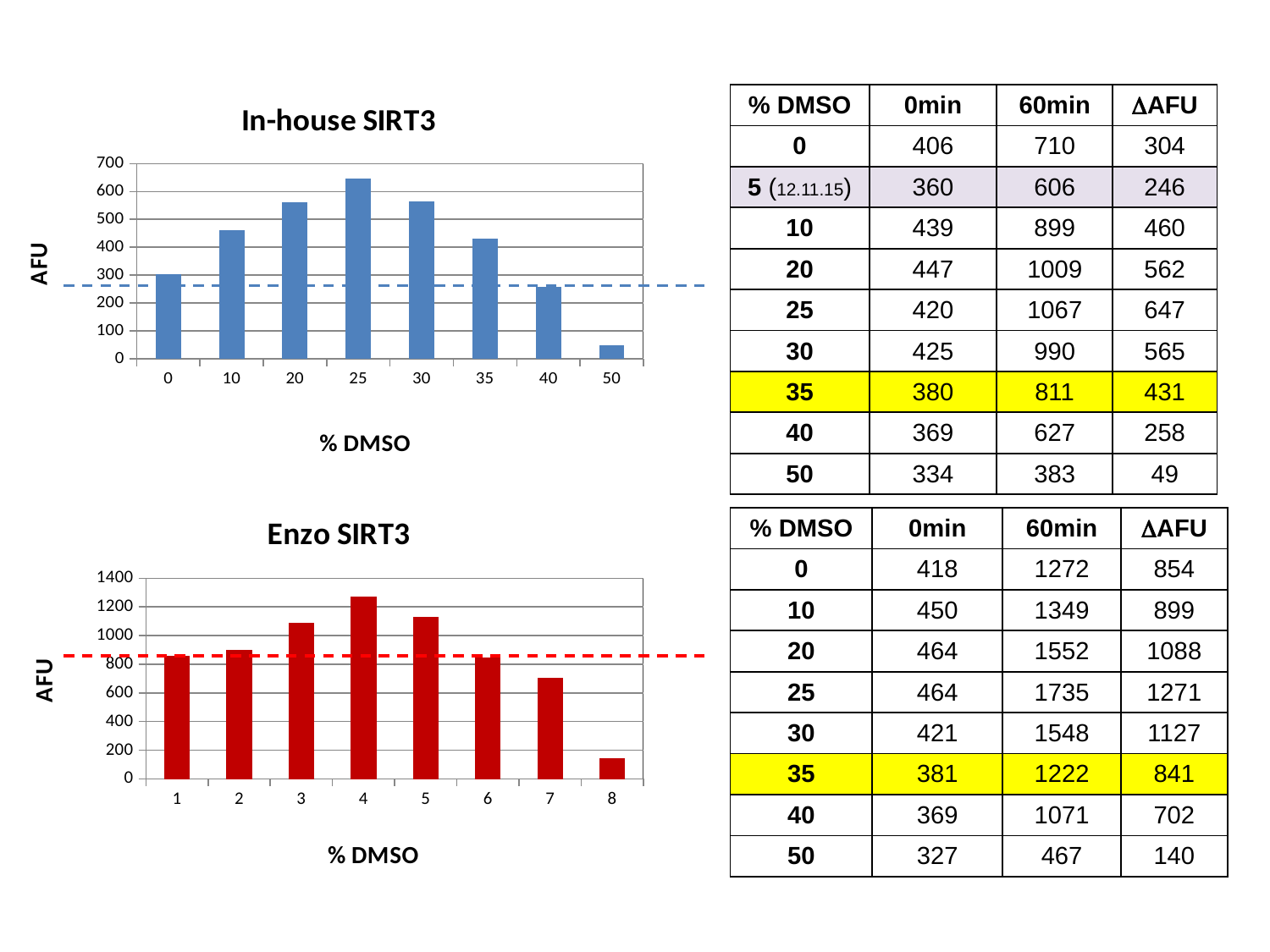
In the Enzo SIRT3 chart, which is larger, the value for category 2 or for category 7? 2 In the In-house SIRT3 chart, is the value for 40% DMSO greater or less than 300? less In the In-house SIRT3 chart, which is larger, the value for 20% DMSO or for 35% DMSO? 20 In the In-house SIRT3 chart, is the value for 10% DMSO greater or less than 400? greater In the In-house SIRT3 chart, which % DMSO category has the lowest AFU? 50 In the In-house SIRT3 chart, which % DMSO category has the highest AFU? 25 What colour is the dashed horizontal line in the Enzo SIRT3 chart? red In the Enzo SIRT3 chart, which category has the highest AFU? 4 What kind of chart is the In-house SIRT3 chart? bar chart In the Enzo SIRT3 chart, is the value for category 7 greater or less than 800? less How many bars are plotted in the In-house SIRT3 chart? 8 In the Enzo SIRT3 chart, which category has the lowest AFU? 8